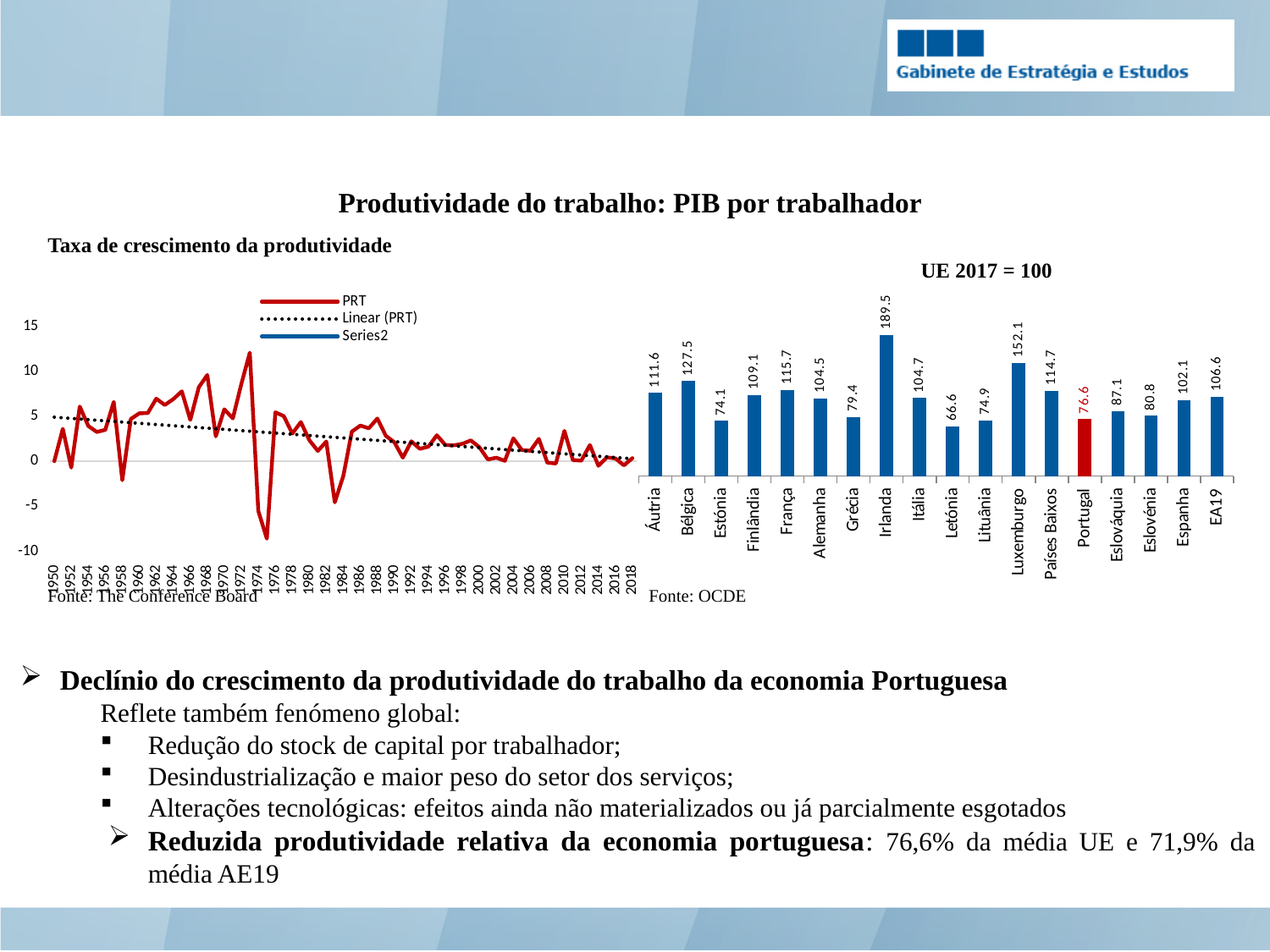
How many bars are shown in the 'UE 2017 = 100' bar chart? 18 In the 'UE 2017 = 100' bar chart, which bar is coloured red? Portugal In the 'UE 2017 = 100' bar chart, what is the value for Portugal? 76.6 What kind of chart is the 'Taxa de crescimento da produtividade' chart on the left? Line chart In the 'Taxa de crescimento da produtividade' chart, does the dotted linear trend line rise or fall from 1950 to 2018? Fall In the 'UE 2017 = 100' bar chart, what is the value for Irlanda? 189.5 In the 'UE 2017 = 100' bar chart, which country has the highest value? Irlanda In the 'UE 2017 = 100' bar chart, what is the difference between Luxemburgo and Portugal? 75.5 In the 'UE 2017 = 100' bar chart, which country has the lowest value? Letónia In the 'UE 2017 = 100' bar chart, which is larger, Bélgica or França? Bélgica In the 'UE 2017 = 100' bar chart, what is the value for EA19? 106.6 How many entries does the legend of the 'Taxa de crescimento da produtividade' chart list? 3